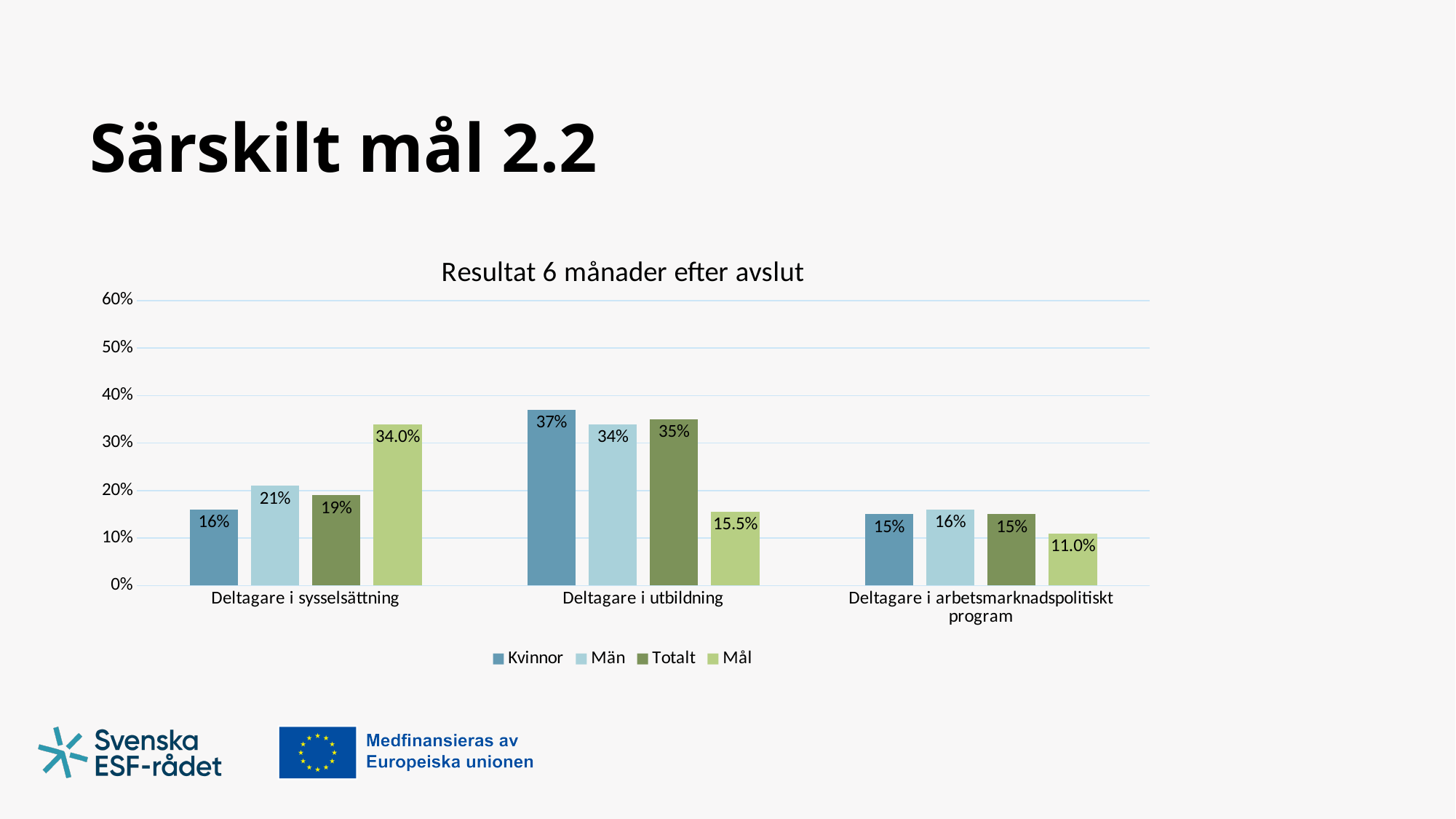
What is the value for Totalt in the Deltagare i arbetsmarknadspolitiskt program category? 15% What is the difference between the Mål value and the Totalt value for Deltagare i sysselsättning? 15.0% Which category has the lowest Mål value? Deltagare i arbetsmarknadspolitiskt program How many categories are shown on the x axis? 3 What is the value for Kvinnor in the Deltagare i sysselsättning category? 16% Which is larger for Deltagare i utbildning, the Kvinnor value or the Män value? Kvinnor What kind of chart is shown on the slide? Bar chart What is the Mål value for Deltagare i sysselsättning? 34.0% What is the Mål value for Deltagare i utbildning? 15.5% Which category has the highest Kvinnor value? Deltagare i utbildning What is the title of the chart? Resultat 6 månader efter avslut How many series does the legend list? 4